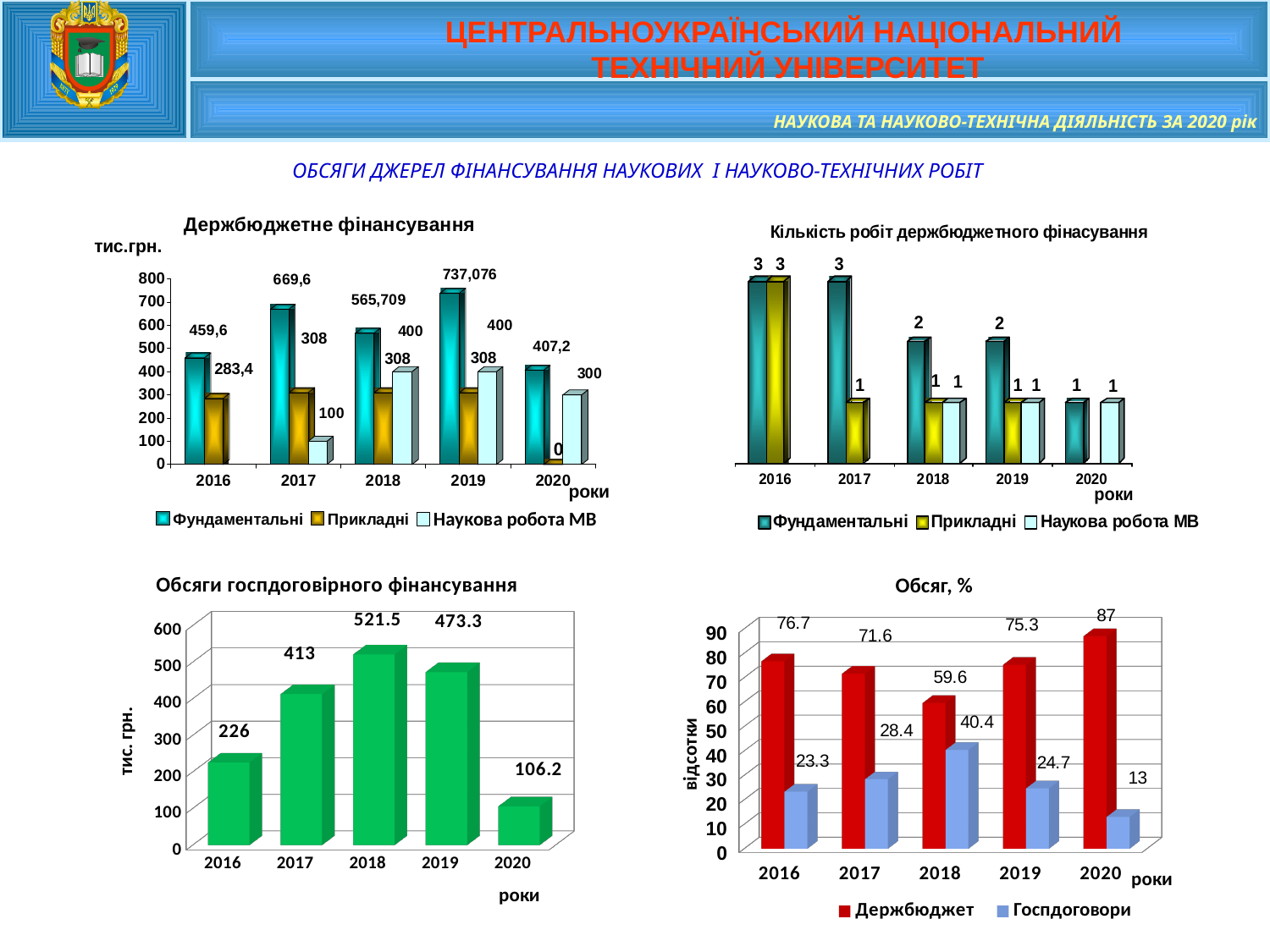
In the 'Кількість робіт держбюджетного фінасування' chart, what is the value for Прикладні in 2016? 3 In the 'Обсяги госпдоговірного фінансування' chart, which year has the lowest value? 2020 In the 'Кількість робіт держбюджетного фінасування' chart, what is the value for Фундаментальні in 2018? 2 In the 'Обсяги госпдоговірного фінансування' chart, what is the difference between the values for 2018 and 2019? 48.2 In the 'Обсяг, %' chart, which is larger in 2020: Держбюджет or Госпдоговори? Держбюджет In the 'Держбюджетне фінансування' chart, which year has the highest value for Фундаментальні? 2019 What type of chart is the 'Обсяги госпдоговірного фінансування' chart? bar chart In the 'Обсяги госпдоговірного фінансування' chart, which year has the highest value? 2018 In the 'Держбюджетне фінансування' chart, what is the value for Фундаментальні in 2019? 737,076 How many series does the legend of the 'Держбюджетне фінансування' chart list? 3 In the 'Держбюджетне фінансування' chart, what is the value for Наукова робота МВ in 2020? 300 In the 'Обсяг, %' chart, what is the value for Госпдоговори in 2018? 40.4